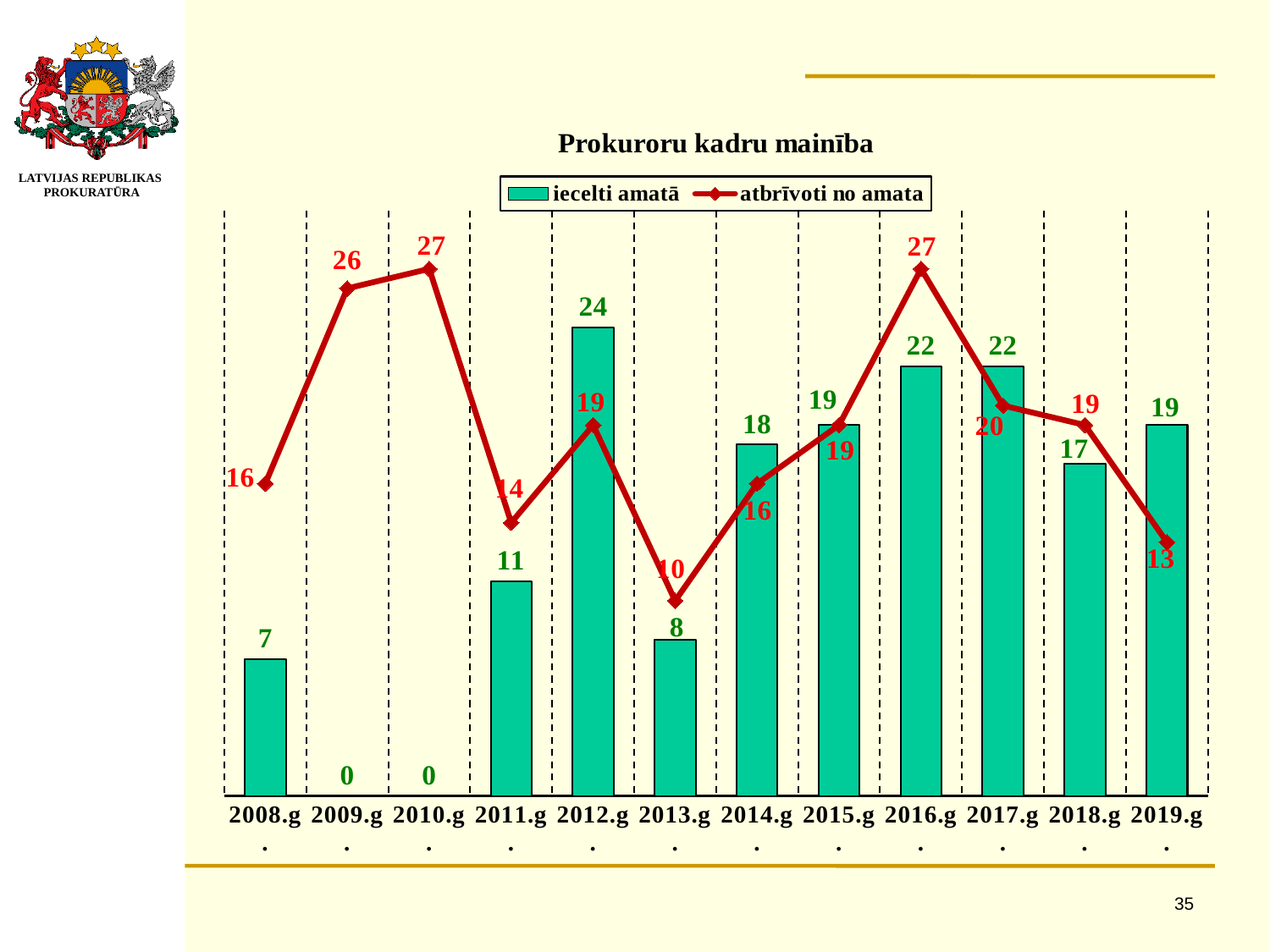
What is the value of 'atbrīvoti no amata' for 2019.g? 13 Which is larger in 2017.g: 'iecelti amatā' or 'atbrīvoti no amata'? iecelti amatā What kind of chart is this? Combined bar and line chart In which year is the 'atbrīvoti no amata' value lowest? 2013.g What is the title of the chart? Prokuroru kadru mainība In which year is the 'iecelti amatā' value highest? 2012.g How many series does the legend list? 2 How many years are shown on the x axis? 12 What is the value of 'iecelti amatā' for 2009.g? 0 What is the difference between 'atbrīvoti no amata' and 'iecelti amatā' in 2010.g? 27 What is the value of 'atbrīvoti no amata' for 2013.g? 10 What is the value of 'iecelti amatā' for 2012.g? 24